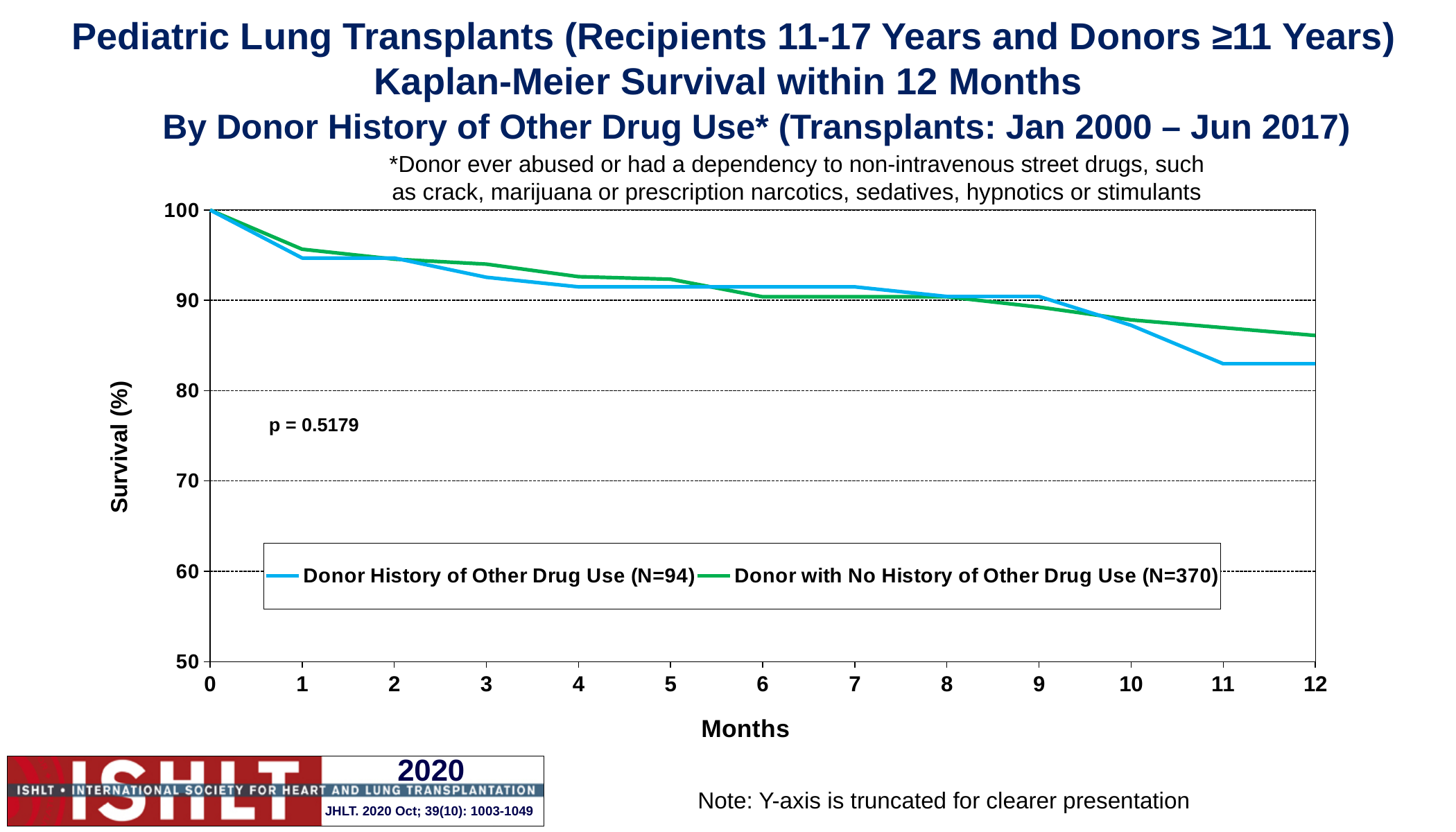
Is the survival value for Donor with No History of Other Drug Use (N=370) at 3 months greater or less than 90? greater What is the label of the y axis? Survival (%) At 12 months, which series has the higher survival value? Donor with No History of Other Drug Use (N=370) What kind of chart is shown on the slide? line chart How many series does the legend list? 2 Do the survival values rise or fall as months increase? fall Is the survival value for Donor History of Other Drug Use (N=94) at 12 months greater or less than 90? less What p-value is printed on the chart? p = 0.5179 What is the survival value for both series at 0 months? 100 Is the survival value for Donor with No History of Other Drug Use (N=370) at 12 months greater or less than 80? greater How many month tick marks are shown on the x axis? 13